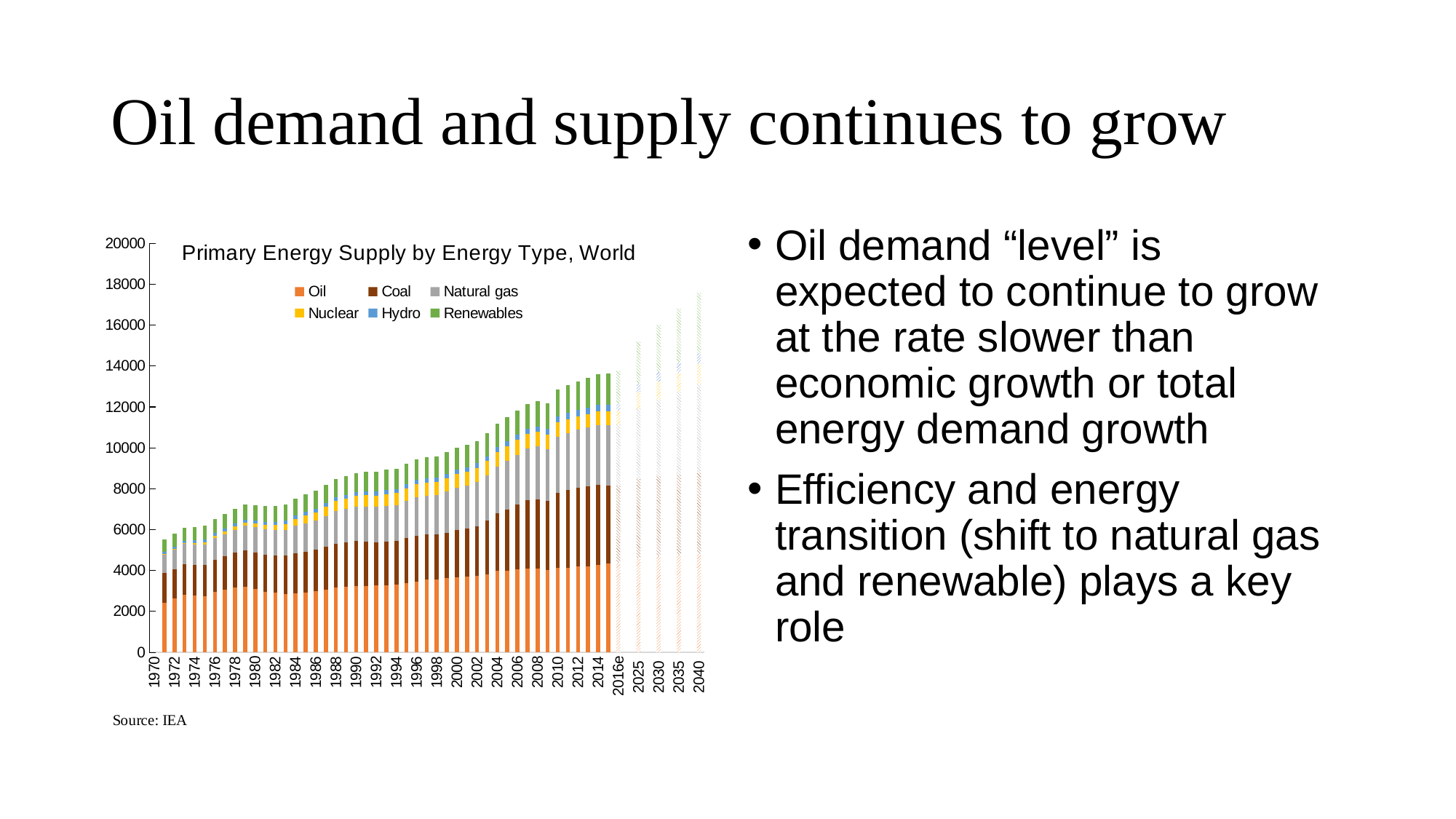
Which energy types are listed in the chart legend? Oil, Coal, Natural gas, Nuclear, Hydro, Renewables Is the total primary energy supply for 2040 greater or less than 16000? greater Which year has a larger total primary energy supply, 1990 or 2014? 2014 Which year has the highest total primary energy supply in the chart? 2040 How many series does the chart legend list? 6 Is the total primary energy supply for 2014 greater or less than 12000? greater What kind of chart is shown on the slide? Stacked bar chart How many projection years after 2016e are shown on the x axis? 4 What is the title of the chart? Primary Energy Supply by Energy Type, World Does the total primary energy supply generally rise or fall from 1970 to 2040? Rise